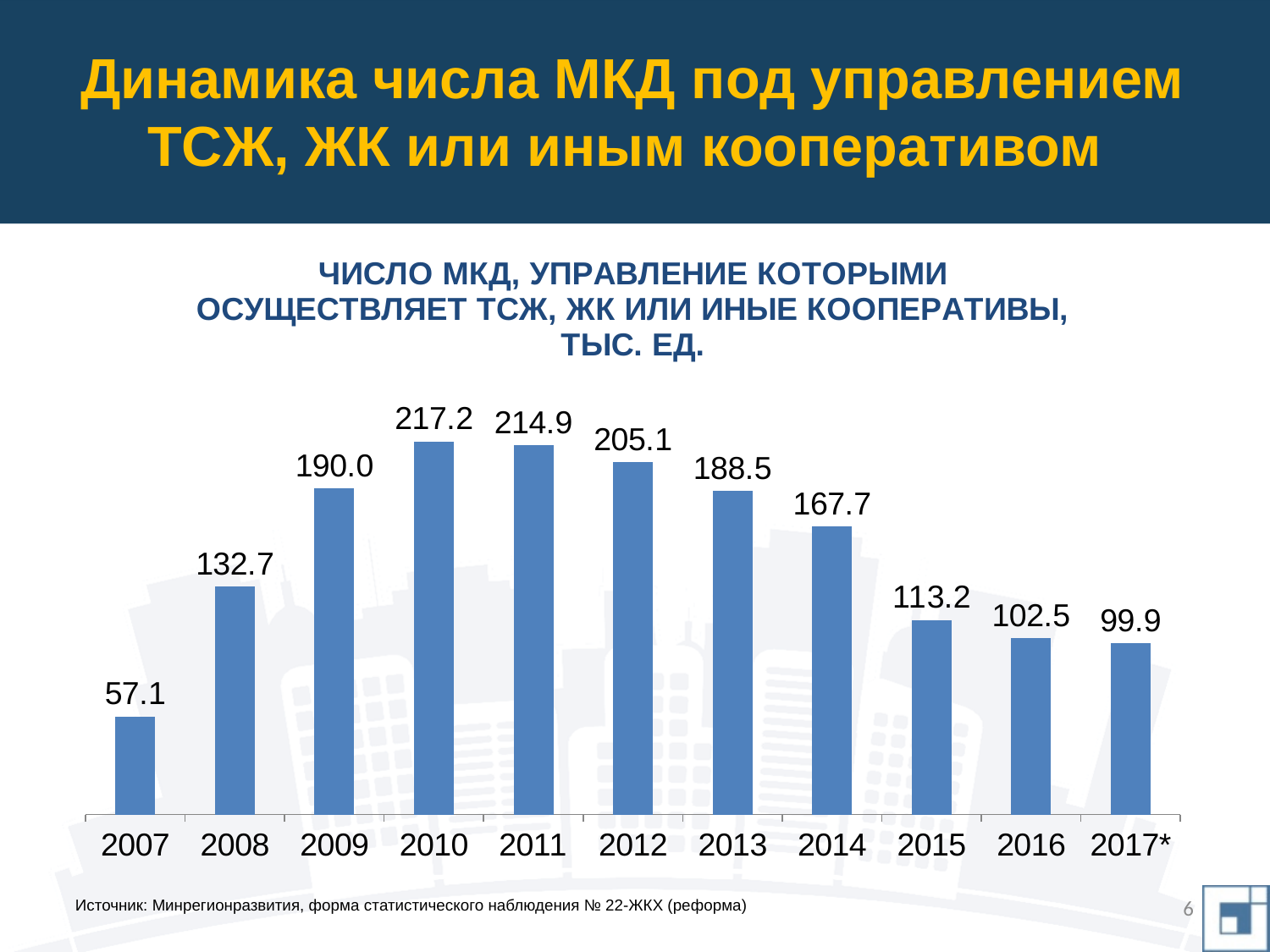
What unit is stated in the chart title? тыс. ед. Do the values rise or fall from 2012 to 2017*? fall Which is larger, the value for 2013 or the value for 2014? 2013 What is the difference between the values for 2010 and 2017*? 117.3 What is the value for 2007? 57.1 What kind of chart is this? bar chart What is the value for 2017*? 99.9 What is the difference between the values for 2008 and 2007? 75.6 Which year has the lowest value? 2007 What is the value for 2010? 217.2 How many years are shown on the x axis? 11 Which year has the highest value? 2010